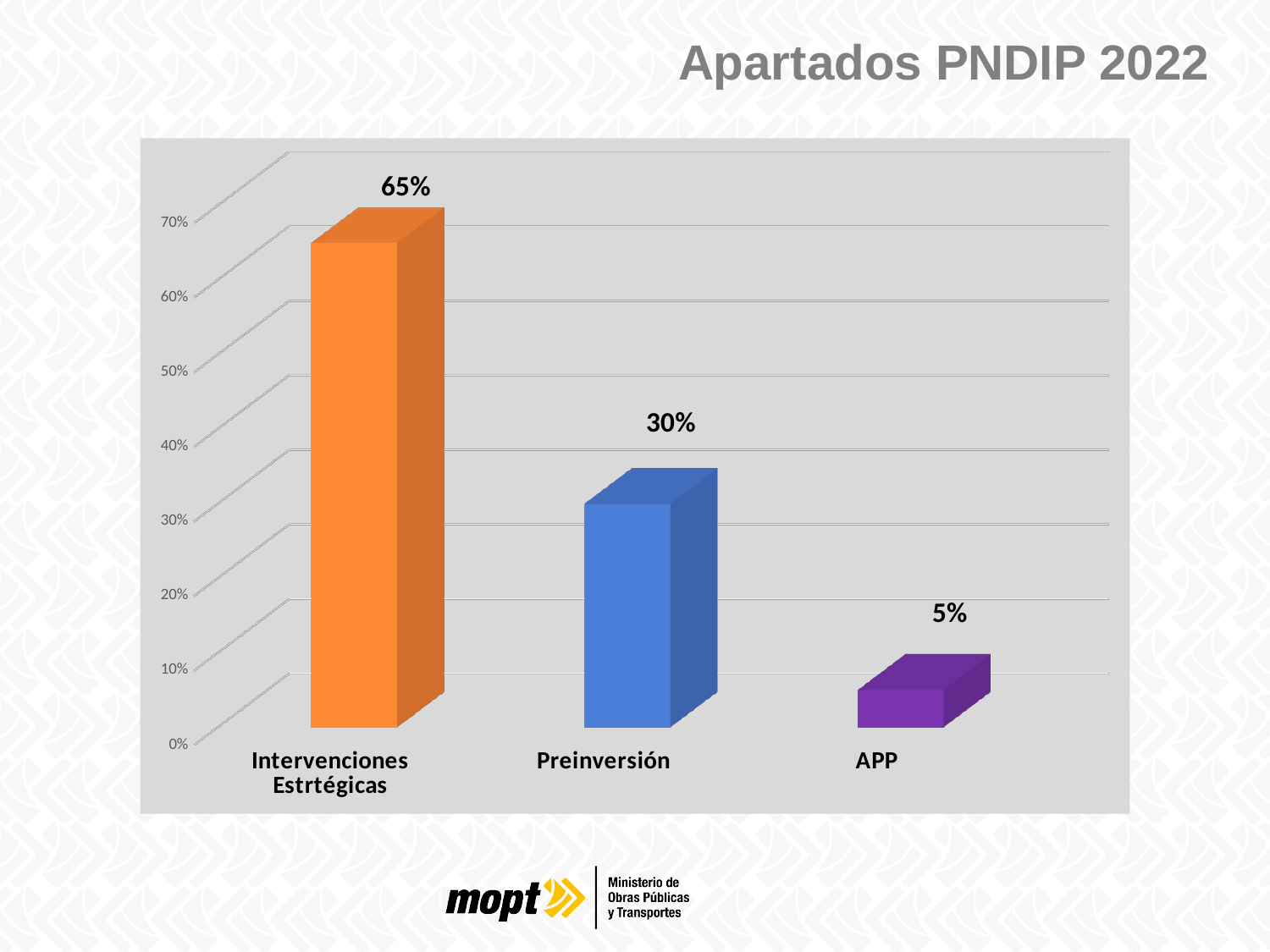
Which category has the highest value? Intervenciones Estrtégicas Is the value for Intervenciones Estrtégicas greater or less than 60%? greater What is the difference between the values for Preinversión and APP? 25% What is the title of the slide? Apartados PNDIP 2022 How many categories are shown on the chart? 3 Which is larger, the value for Preinversión or the value for APP? Preinversión Which category has the lowest value? APP What is the value for Intervenciones Estrtégicas? 65% What kind of chart is shown on the slide? bar chart What is the value for Preinversión? 30% What is the difference between the values for Intervenciones Estrtégicas and Preinversión? 35% What is the value for APP? 5%